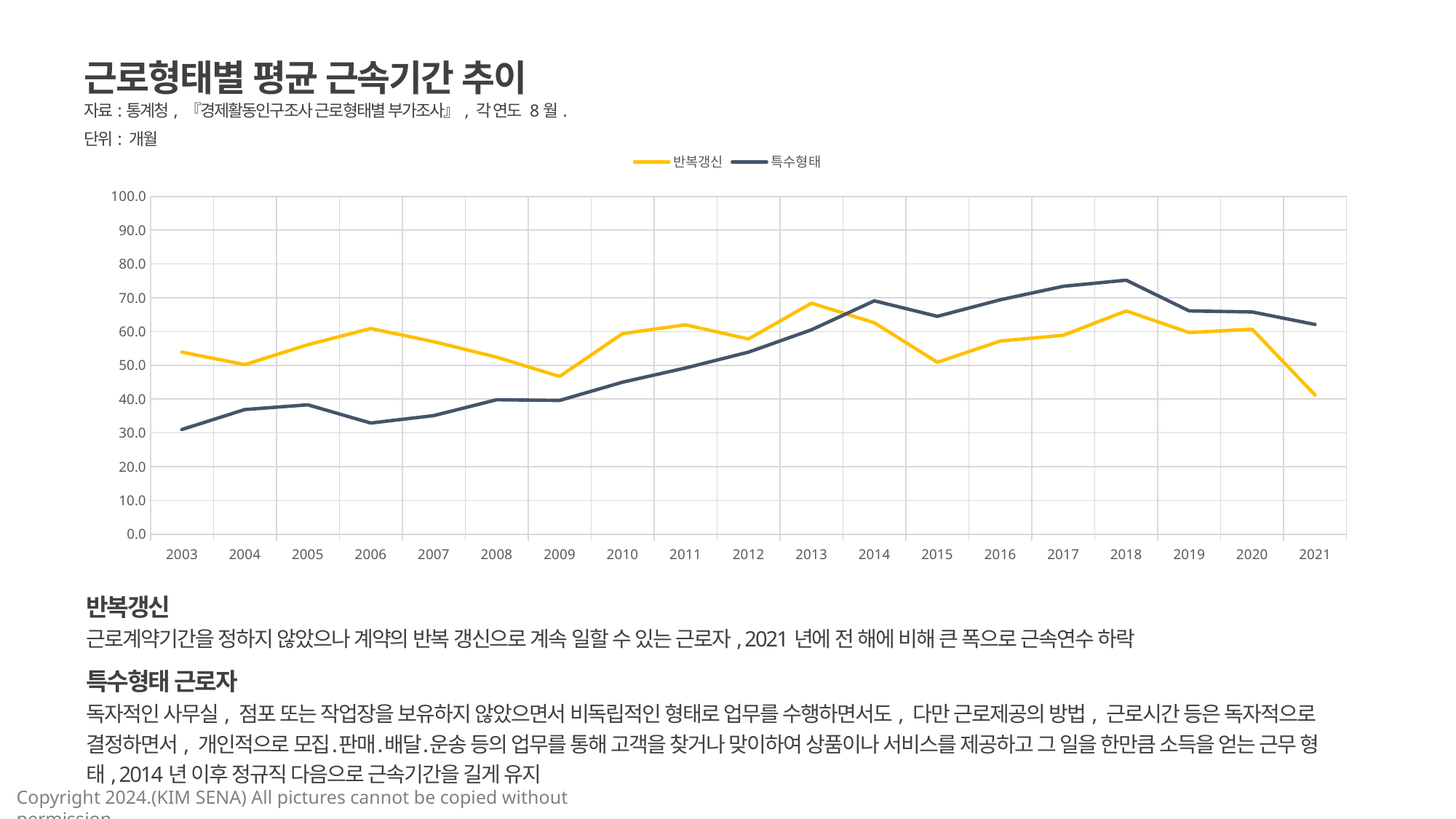
Is the value for 특수형태 in 2018 greater or less than 70? greater In which year does the 특수형태 series have its lowest value? 2003 In 2003, which series has the larger value, 반복갱신 or 특수형태? 반복갱신 How many years are plotted along the x axis? 19 In 2021, which series has the larger value, 반복갱신 or 특수형태? 특수형태 Is the value for 특수형태 in 2003 greater or less than 40? less In which year does the 반복갱신 series have its lowest value? 2021 Does the 특수형태 series generally rise or fall from 2003 to 2014? rise How many series does the legend list? 2 In which year does the 특수형태 series reach its highest value? 2018 Is the value for 반복갱신 in 2021 greater or less than 50? less What kind of chart is shown on the slide? line chart